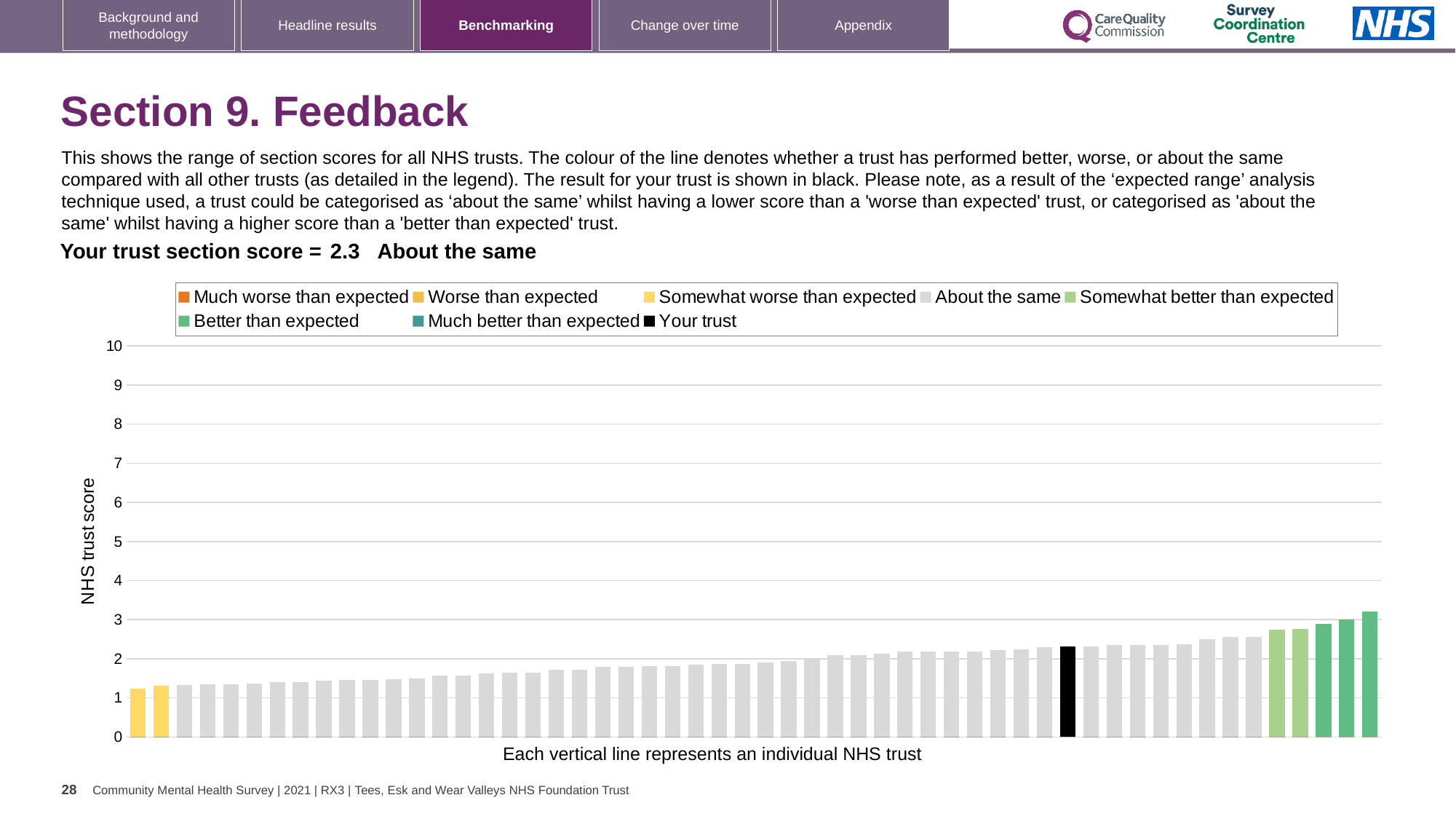
Which category is your trust placed in? About the same What is the label on the vertical axis of the chart? NHS trust score Which legend category does the lowest-scoring trust belong to? Somewhat worse than expected Is the value of the lowest bar greater or less than 2? less Is the value for your trust greater or less than 2? greater Do the bar values rise or fall from left to right along the x axis? rise What kind of chart is shown on the slide? bar chart Is the value of the highest bar greater or less than 3? greater What is the section score for your trust? 2.3 Which legend category does the highest-scoring trust belong to? Better than expected How many entries does the chart legend list? 8